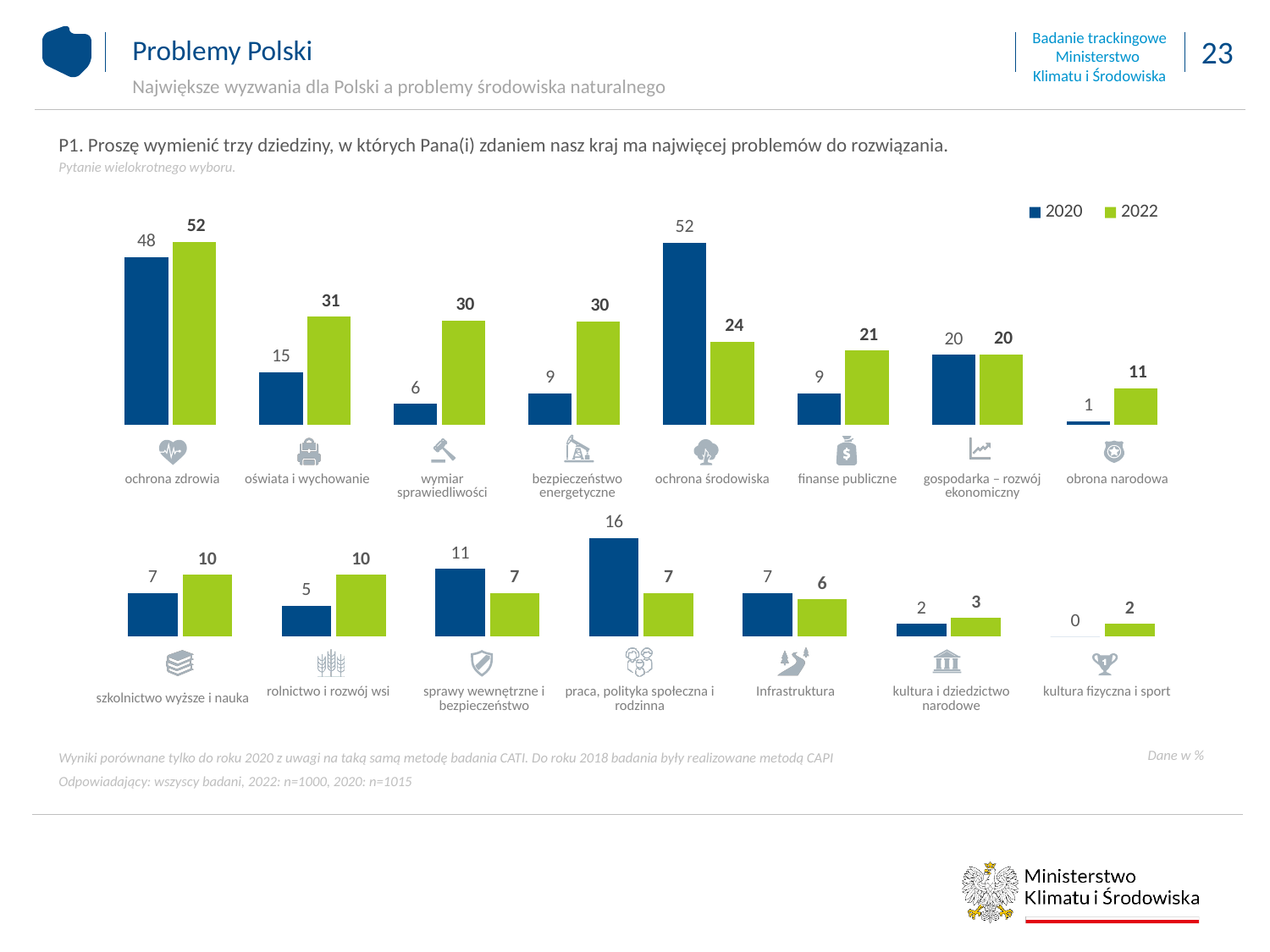
What kind of chart is shown on the slide? bar chart Which colour represents the 2022 series in the legend? green What is the difference between the 2020 and 2022 values for ochrona środowiska? 28 What is the 2020 value for ochrona środowiska? 52 Which category has the highest 2022 value? ochrona zdrowia How many categories are shown in the chart? 15 What is the 2022 value for ochrona zdrowia? 52 Which is larger for praca, polityka społeczna i rodzinna: the 2020 value or the 2022 value? 2020 How many series does the legend list? 2 Which category has the lowest 2020 value? kultura fizyczna i sport What is the 2022 value for wymiar sprawiedliwości? 30 What is the 2020 value for obrona narodowa? 1